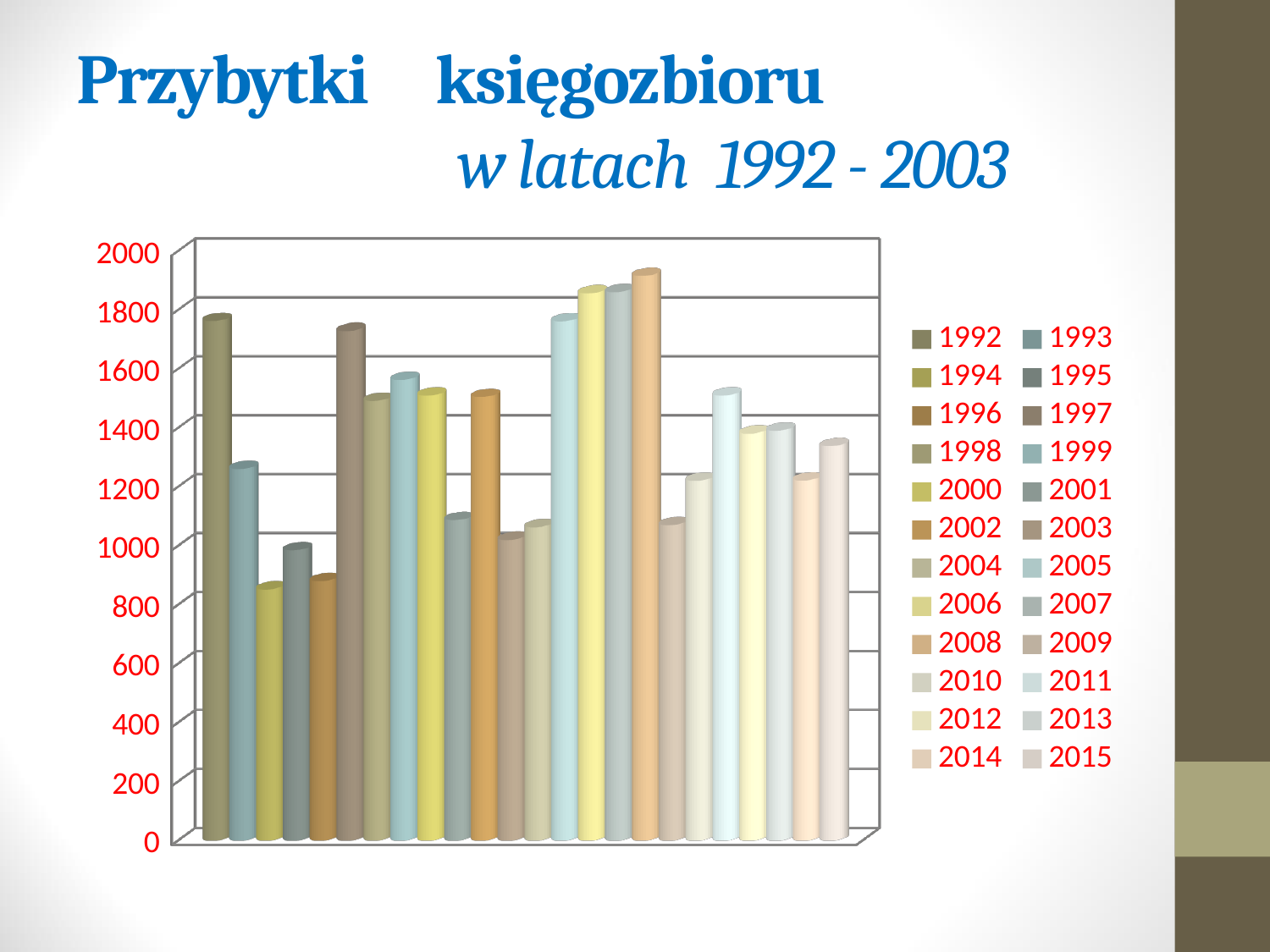
Which is larger, the value for 2008 or the value for 2009? 2008 What kind of chart is shown on the slide? bar chart Is the value for 2001 greater or less than 1200? less What is the highest value shown on the vertical axis? 2000 Is the value for 1992 greater or less than 1600? greater Is the value for 2010 greater or less than 1400? less How many series does the legend list? 24 What is the first year listed in the chart legend? 1992 Which is larger, the value for 1992 or the value for 1993? 1992 Which year has the highest bar in the chart? 2008